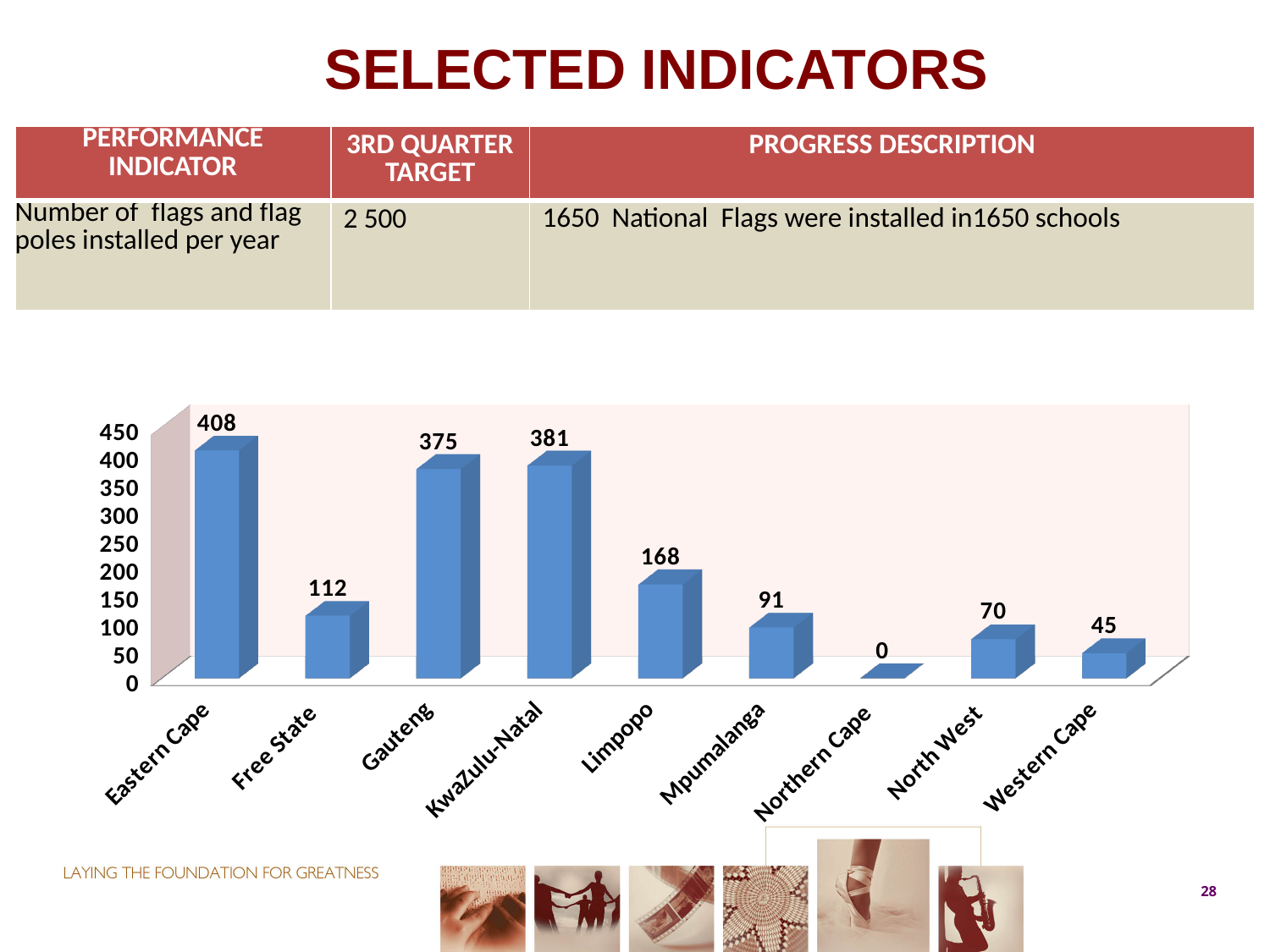
How many provinces are shown on the x axis? 9 Which is larger, the value for Gauteng or the value for KwaZulu-Natal? KwaZulu-Natal What is the difference between the values for North West and Western Cape? 25 Is the value for Mpumalanga greater or less than 100? less What kind of chart is shown on the slide? bar chart What is the value for Eastern Cape? 408 What is the value for Western Cape? 45 What is the difference between the values for Eastern Cape and Free State? 296 What is the highest value shown on the vertical axis? 450 Which province has the highest value? Eastern Cape Which province has the lowest value? Northern Cape What is the value for Limpopo? 168